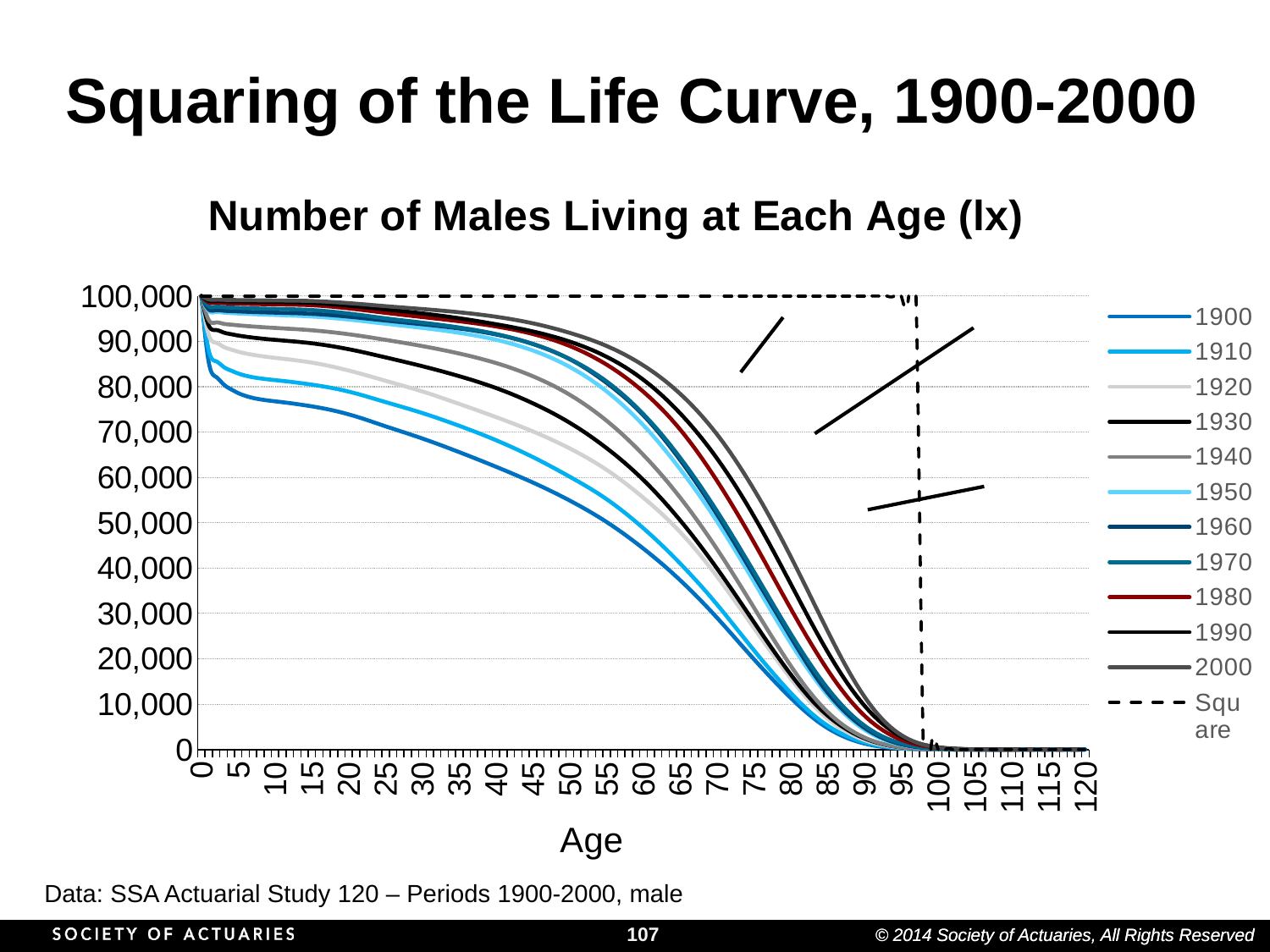
At age 50, which series has the higher value, 1900 or 2000? 2000 What is the label of the x axis? Age Is the value for the 2000 series at age 60 greater or less than 80,000? greater At age 50, which year series has the lowest value? 1900 What kind of chart is shown on the slide? line chart What is the title of the chart? Number of Males Living at Each Age (lx) Do the values of the 1900 series rise or fall as age increases? fall Is the value for the 1900 series at age 60 greater or less than 50,000? less How many series does the legend list? 12 Is the value for the 1900 series at age 20 greater or less than 80,000? less At age 50, which year series has the highest value? 2000